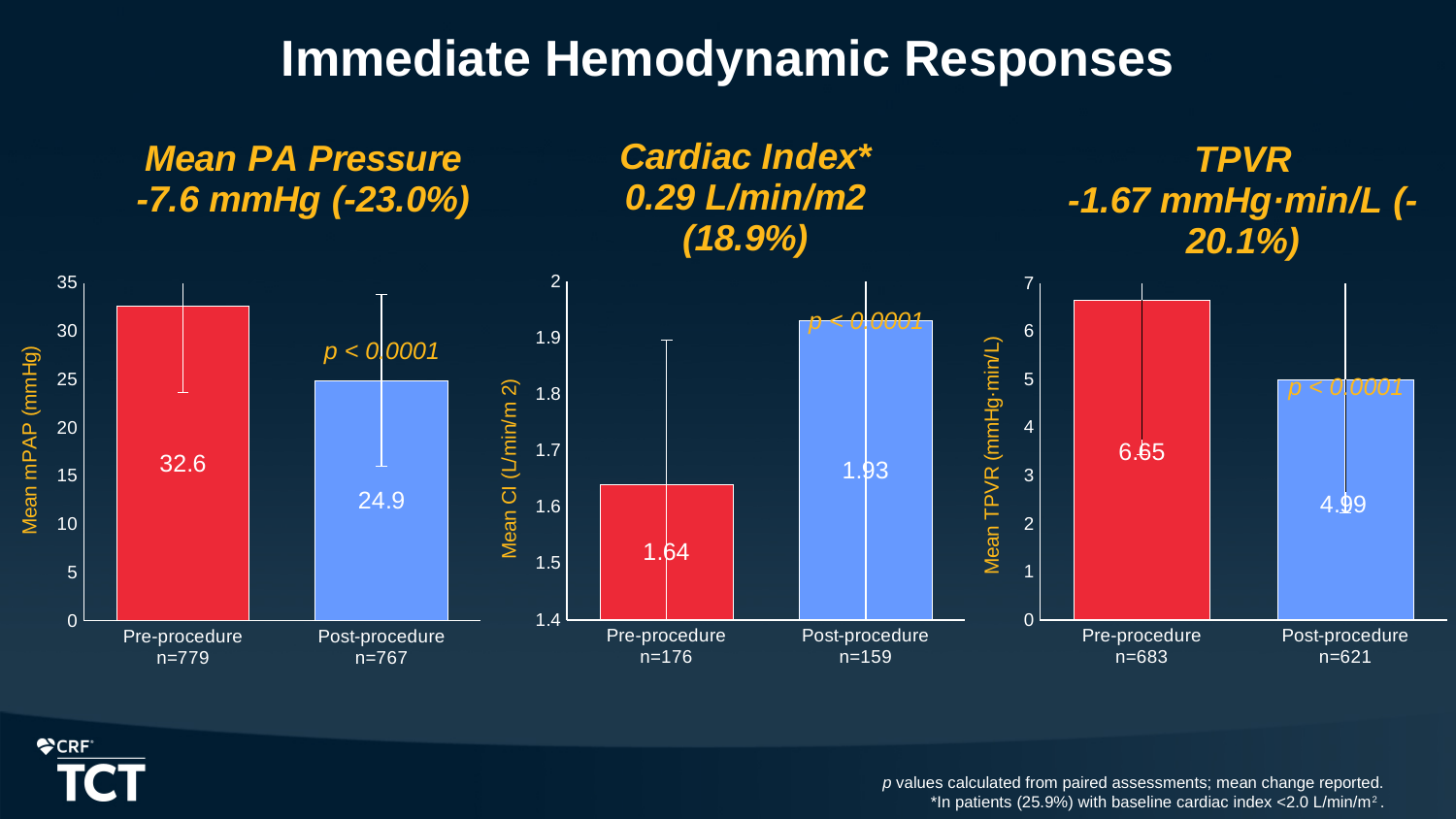
In the TPVR chart, what is the value for Pre-procedure? 6.65 In the Mean PA Pressure chart, what is the value for Post-procedure? 24.9 In the TPVR chart, is the value for Post-procedure greater or less than 5? less In the Cardiac Index chart, what is the value for Post-procedure? 1.93 In the Cardiac Index chart, what is the difference between the Post-procedure and Pre-procedure values? 0.29 What kind of chart is the Mean PA Pressure chart? Bar chart How many categories are shown on the x axis of the Cardiac Index chart? 2 In the Cardiac Index chart, which bar is higher, Pre-procedure or Post-procedure? Post-procedure In the TPVR chart, which category has the lowest value? Post-procedure In the Mean PA Pressure chart, what is the value for Pre-procedure? 32.6 What is the y-axis label of the TPVR chart? Mean TPVR (mmHg·min/L) In the Mean PA Pressure chart, what is the difference between the Pre-procedure and Post-procedure values? 7.7